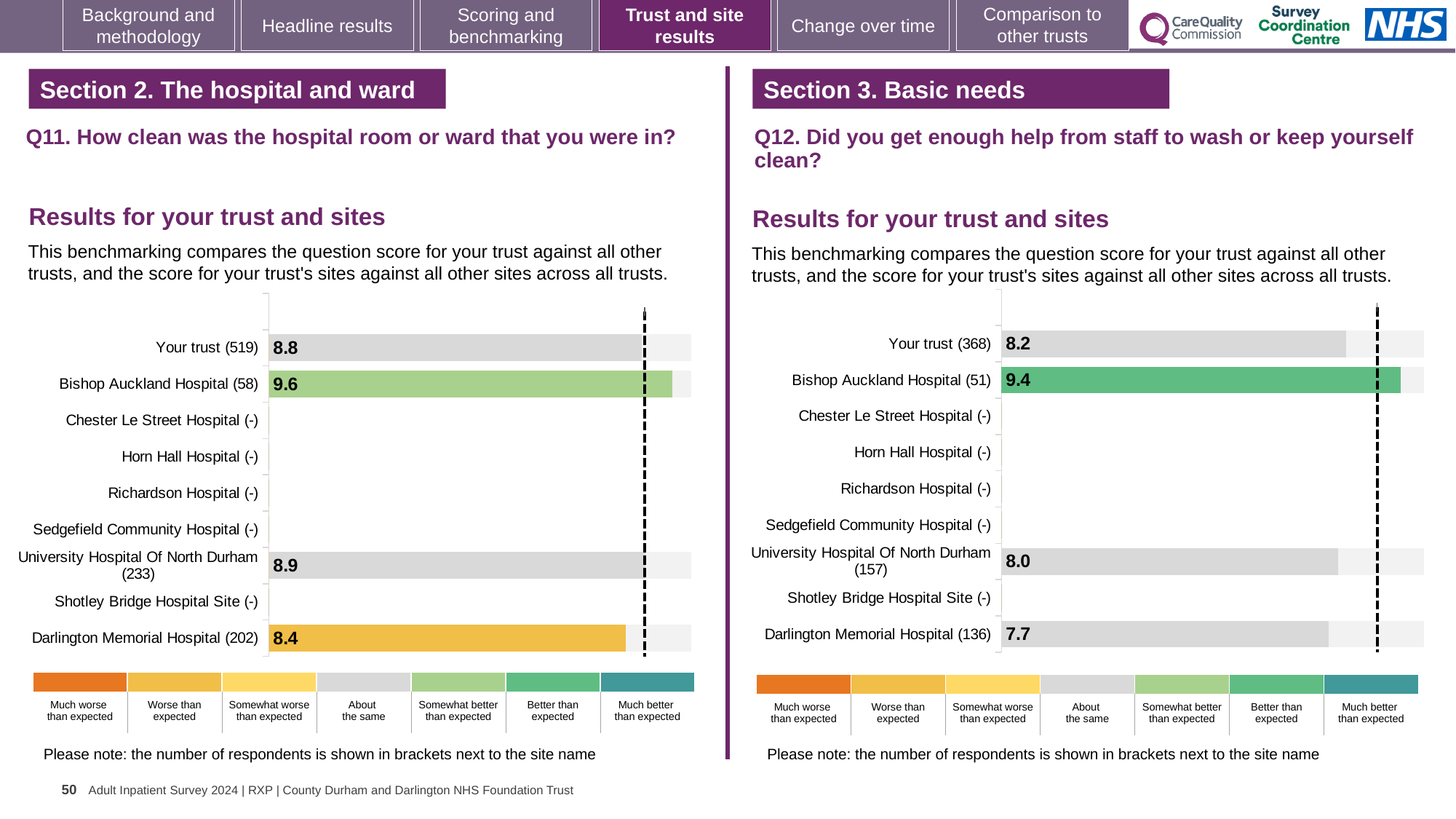
What type of chart is used for the Q11 results? Bar chart How many benchmark categories does the legend below the Q12 chart list? 7 In the Q11 chart, what is the score for Bishop Auckland Hospital? 9.6 In the Q12 chart, which is higher: the score for Your trust or the score for University Hospital Of North Durham? Your trust In the Q12 chart (Did you get enough help from staff to wash or keep yourself clean), what is the score for Your trust? 8.2 In the Q12 chart, which site has the highest score? Bishop Auckland Hospital In the Q11 chart, which site has the lowest score? Darlington Memorial Hospital In the Q12 chart, what is the difference between the scores for Your trust and Darlington Memorial Hospital? 0.5 In the Q11 chart, what is the difference between the scores for Bishop Auckland Hospital and Darlington Memorial Hospital? 1.2 In the Q11 chart (How clean was the hospital room or ward), what is the score for Your trust? 8.8 In the Q12 chart, what is the score for Darlington Memorial Hospital? 7.7 In the Q11 chart, how many respondents are shown for University Hospital Of North Durham? 233